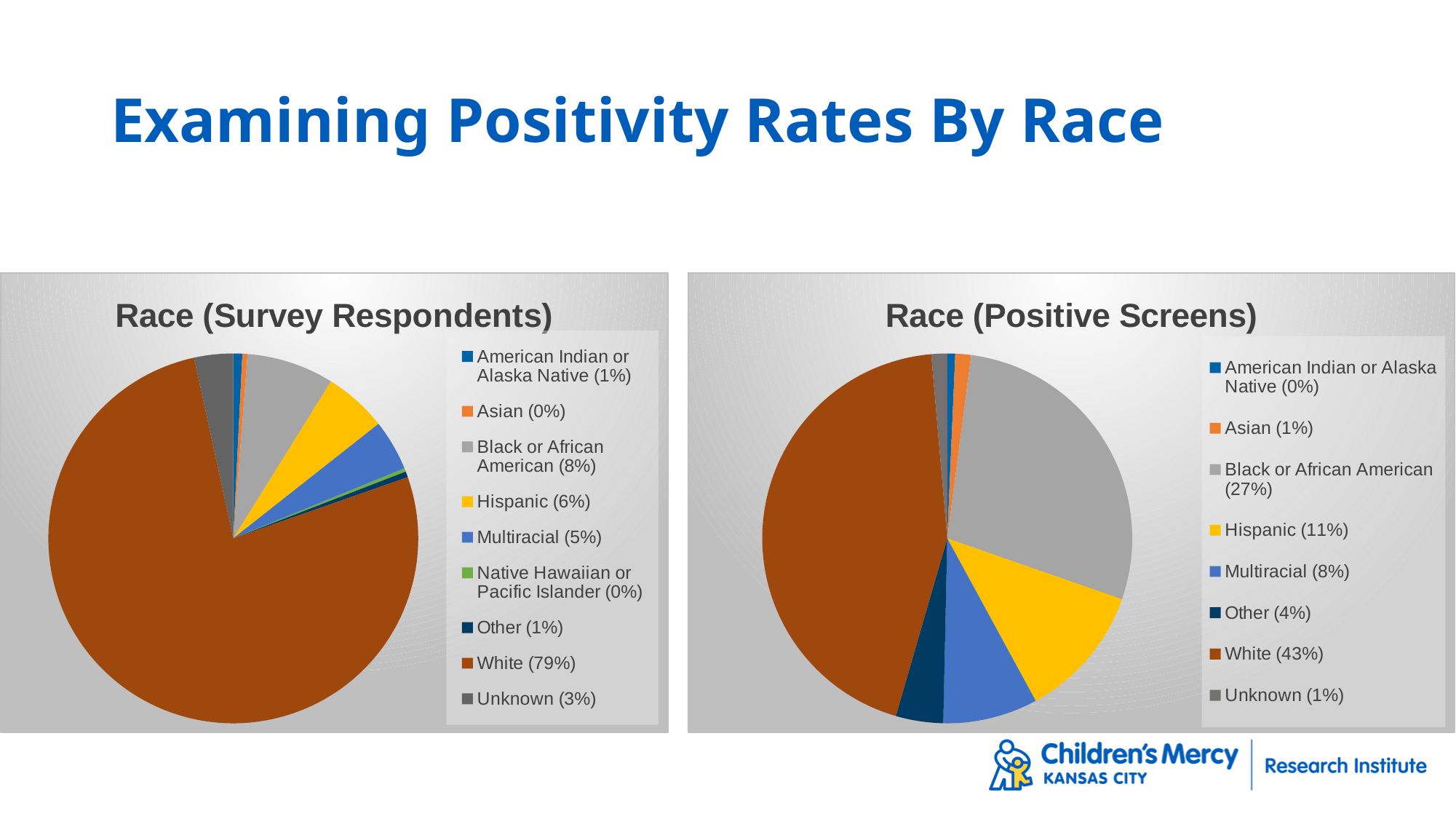
In the 'Race (Positive Screens)' chart, what is the difference between the White share and the Black or African American share? 16% In the 'Race (Positive Screens)' chart, what share of the pie is Hispanic? 11% How many categories does the legend of the 'Race (Survey Respondents)' chart list? 9 What type of chart is the 'Race (Positive Screens)' chart? Pie chart In the 'Race (Survey Respondents)' chart, which category has the largest slice? White In the 'Race (Survey Respondents)' chart, what is the difference between the White share and the Black or African American share? 71% How many categories does the legend of the 'Race (Positive Screens)' chart list? 8 In the 'Race (Survey Respondents)' chart, what share of the pie is Unknown? 3% In the 'Race (Survey Respondents)' chart, what share of the pie is White? 79% In the 'Race (Positive Screens)' chart, which category has the largest slice? White In the 'Race (Positive Screens)' chart, which is larger: the Hispanic slice or the Multiracial slice? Hispanic